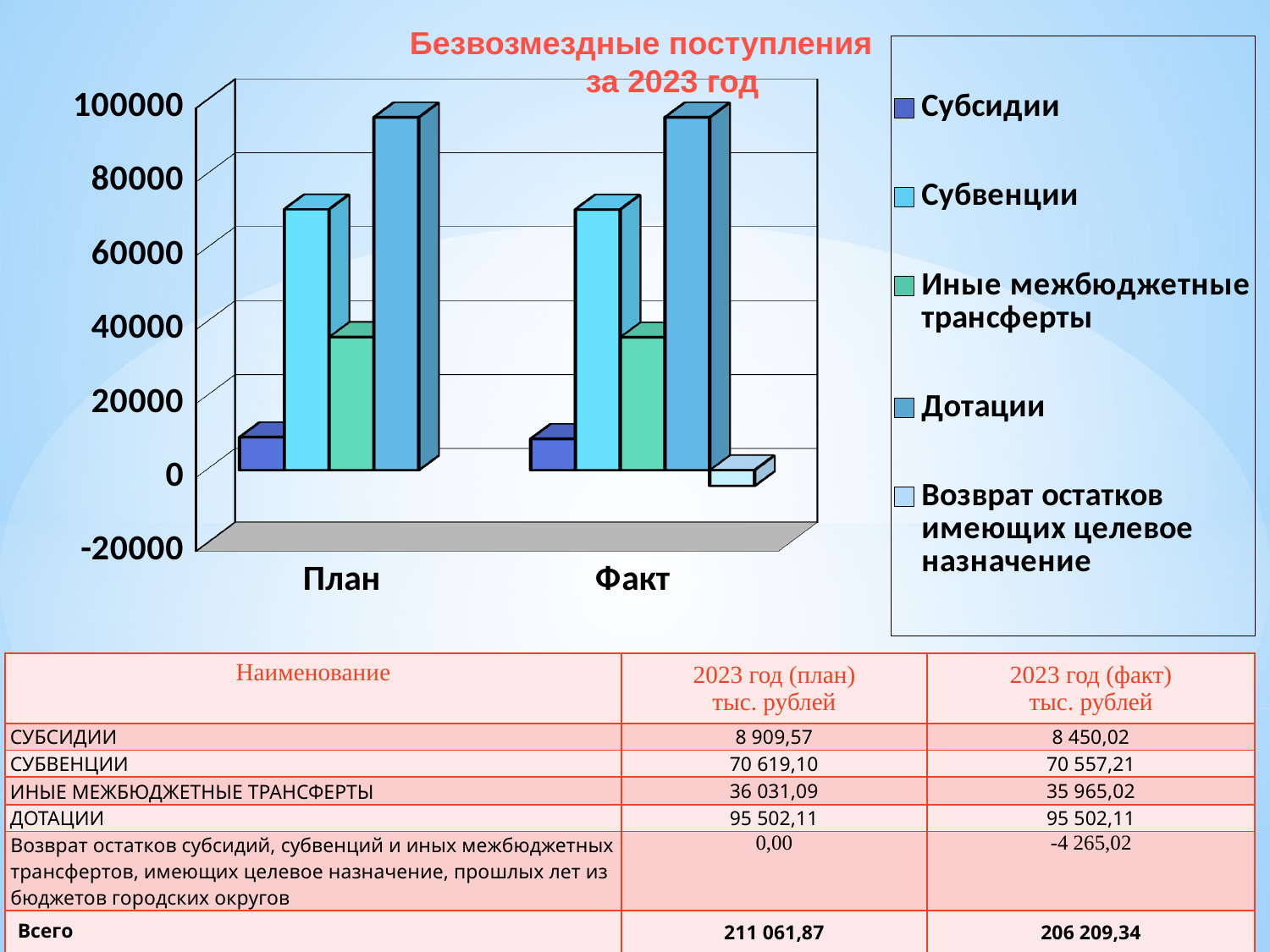
How many series does the chart legend list? 5 Which series has the highest bar in the План category? Дотации According to the table on the slide, what is the 2023 факт value for the return of remaining targeted funds (Возврат остатков) in тыс. рублей? -4 265,02 How many categories are shown on the x axis of the chart? 2 In the Факт category, which is larger: Дотации or Субвенции? Дотации Is the value for Субвенции in the План category greater or less than 60000? greater Is the value for Субсидии in the План category greater or less than 20000? less What is the title of the chart? Безвозмездные поступления за 2023 год According to the table on the slide, what is the 2023 план value for Дотации in тыс. рублей? 95 502,11 What kind of chart is shown on the slide? bar chart Which series has the lowest bar in the Факт category? Возврат остатков имеющих целевое назначение Is the value for Иные межбюджетные трансферты in the Факт category greater or less than 40000? less